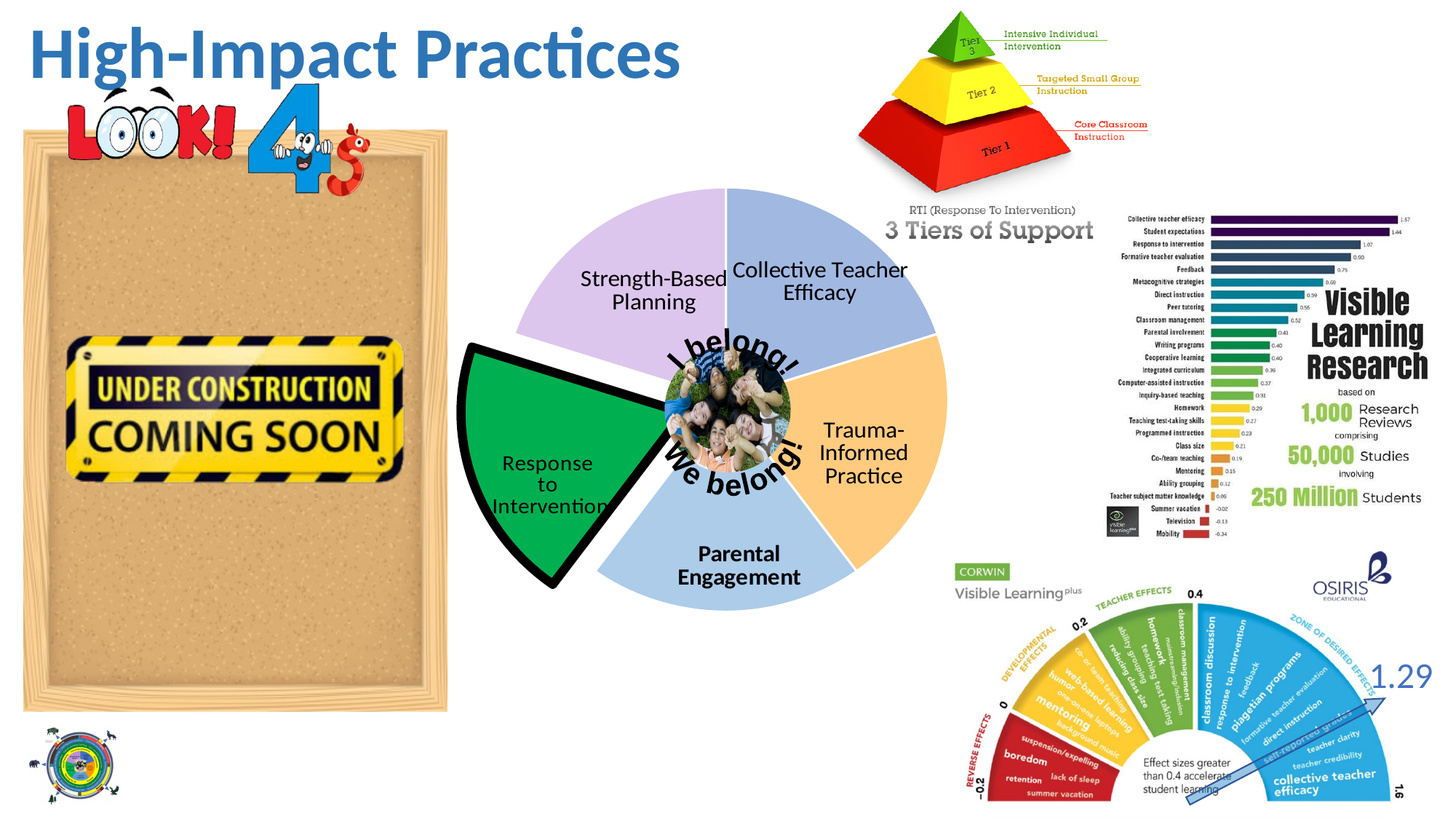
How many slices does the centre pie chart have? 5 In the Visible Learning Research bar chart, what is the value for Collective teacher efficacy? 1.57 What kind of chart is the chart in the centre of the slide with the slices labelled Strength-Based Planning and Collective Teacher Efficacy? pie chart In the Visible Learning Research bar chart, what is the difference between the values for Collective teacher efficacy and Student expectations? 0.13 In the centre pie chart, what text is written around the photo at the centre of the pie? I belong! We belong! In the Visible Learning Research bar chart, what is the value for Student expectations? 1.44 In the Visible Learning Research bar chart, what is the value for Response to intervention? 1.07 In the centre pie chart, which slice is coloured green and pulled out from the rest of the pie? Response to Intervention In the Visible Learning Research bar chart, which has the larger value, Feedback or Homework? Feedback What kind of chart is the Visible Learning Research chart on the right of the slide? bar chart In the Visible Learning Research bar chart, which category has the lowest value? Mobility In the Visible Learning Research bar chart, which category has the highest value? Collective teacher efficacy